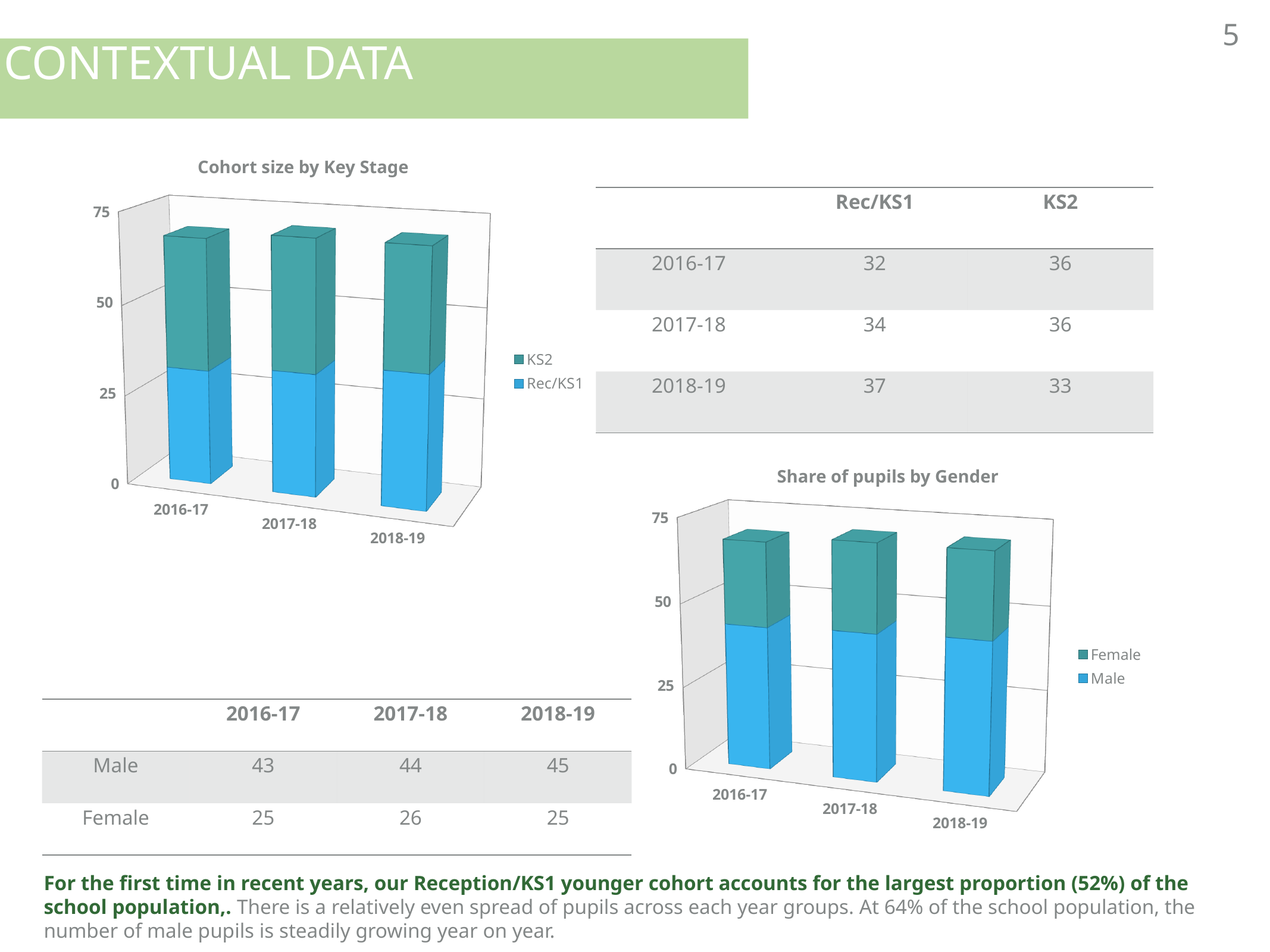
In the 'Cohort size by Key Stage' chart, what is the total height of the stacked bar for 2017-18? 70 In the 'Cohort size by Key Stage' chart, how many year categories are shown on the x axis? 3 In the 'Cohort size by Key Stage' chart, what is the KS2 value for 2016-17? 36 In the 'Cohort size by Key Stage' chart, what is the Rec/KS1 value for 2018-19? 37 In the 'Share of pupils by Gender' chart, which series is larger in 2018-19, Male or Female? Male In the 'Share of pupils by Gender' chart, what is the Male value for 2018-19? 45 In the 'Share of pupils by Gender' chart, what is the difference between the Male and Female values for 2016-17? 18 In the 'Share of pupils by Gender' chart, is the total stacked bar for 2016-17 greater or less than 50? greater What kind of chart is 'Share of pupils by Gender'? stacked bar chart In the 'Cohort size by Key Stage' chart, how many series does the legend list? 2 In the 'Cohort size by Key Stage' chart, does the Rec/KS1 value rise or fall from 2016-17 to 2018-19? rise In the 'Share of pupils by Gender' chart, what is the Female value for 2017-18? 26